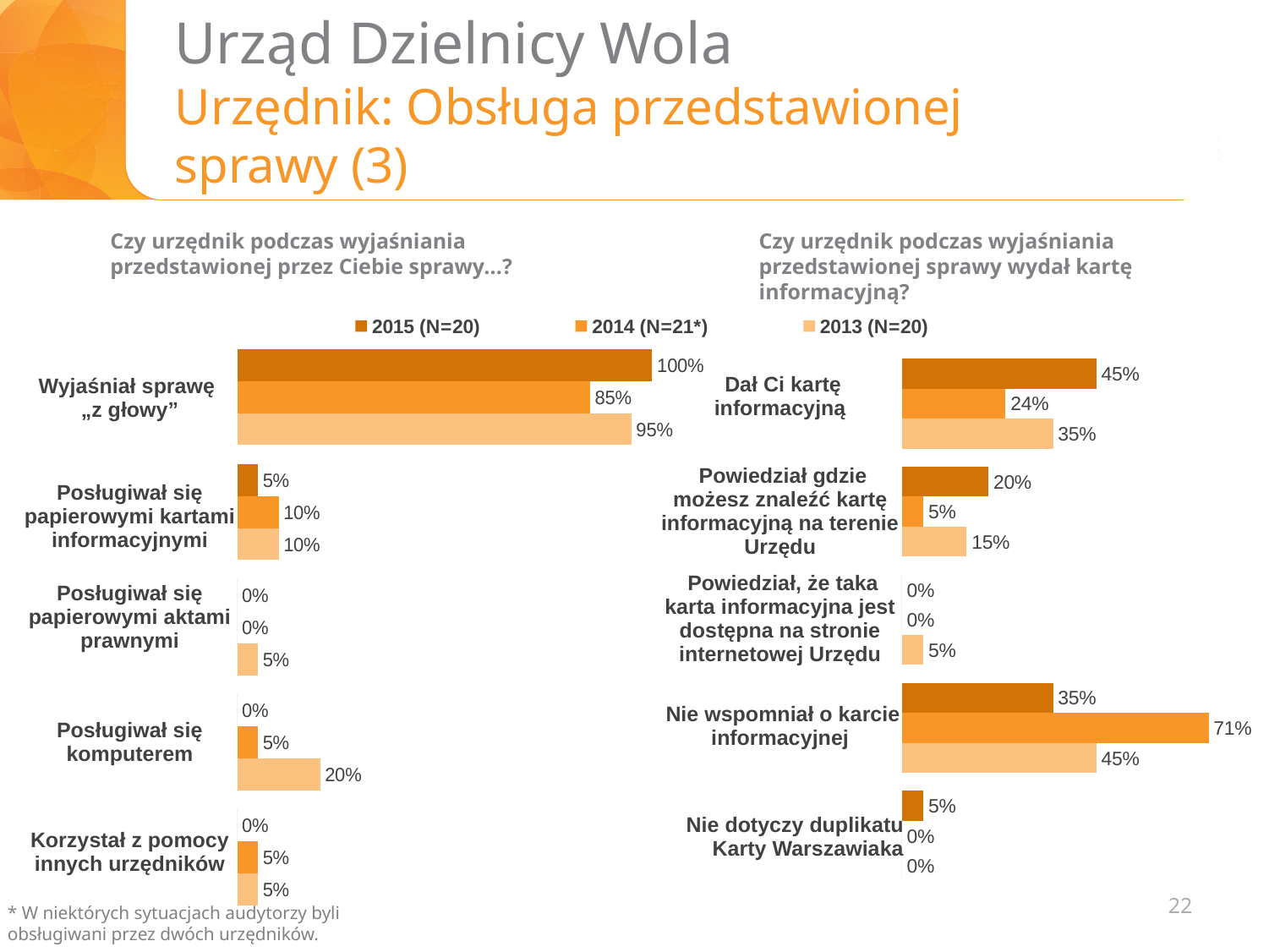
In the left chart, what is the 2014 value for "Wyjaśniał sprawę „z głowy”"? 85% In the left chart, which category has the highest 2015 value? Wyjaśniał sprawę „z głowy” How many categories does the right chart show? 5 In the right chart ("Czy urzędnik podczas wyjaśniania przedstawionej sprawy wydał kartę informacyjną?"), what is the 2014 value for "Nie wspomniał o karcie informacyjnej"? 71% In the right chart, which category has the highest 2014 value? Nie wspomniał o karcie informacyjnej In the right chart, is the 2015 value for "Dał Ci kartę informacyjną" larger or smaller than the 2015 value for "Nie wspomniał o karcie informacyjnej"? larger How many series does the legend list? 3 In the right chart, what is the 2015 value for "Dał Ci kartę informacyjną"? 45% In the left chart, what is the difference between the 2013 and 2015 values for "Wyjaśniał sprawę „z głowy”"? 5% In the right chart, what is the difference between the 2014 and 2015 values for "Nie wspomniał o karcie informacyjnej"? 36% In the left chart ("Czy urzędnik podczas wyjaśniania przedstawionej przez Ciebie sprawy...?"), what is the 2015 value for "Wyjaśniał sprawę „z głowy”"? 100% In the left chart, what is the 2013 value for "Posługiwał się komputerem"? 20%